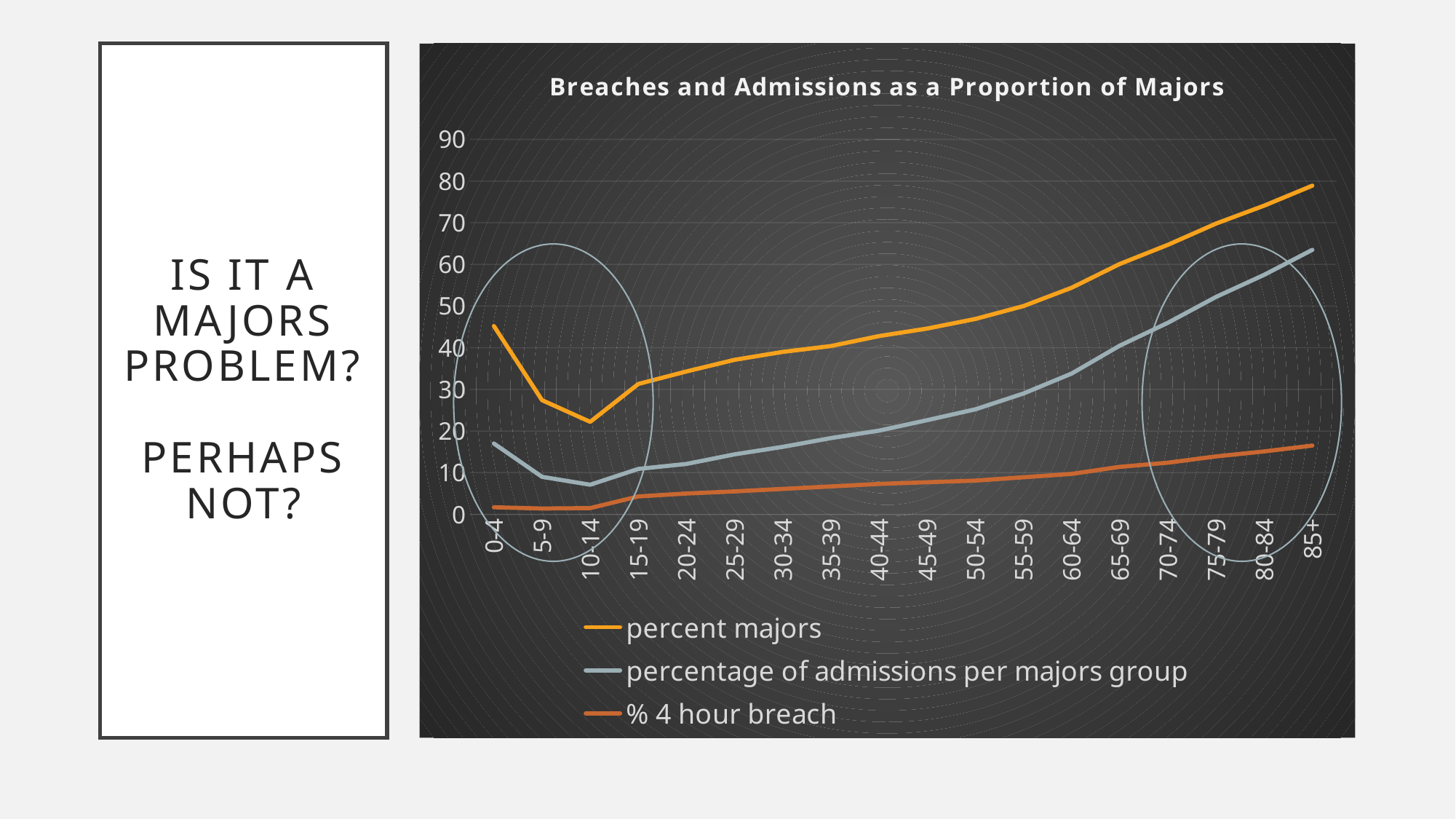
Does the '% 4 hour breach' series rise or fall from 15-19 to 85+? rise Is the 'percent majors' value for 10-14 greater or less than 30? less What kind of chart is shown on the slide? line chart For which age group is the 'percentage of admissions per majors group' series lowest? 10-14 For which age group is the 'percent majors' series lowest? 10-14 How many series does the legend list? 3 For which age group is the 'percent majors' series highest? 85+ How many age-group categories are plotted along the x axis? 18 Is the 'percent majors' value for 85+ greater or less than 70? greater At 85+, which is larger: 'percent majors' or 'percentage of admissions per majors group'? percent majors Is the '% 4 hour breach' value for 85+ greater or less than 20? less What is the title of the chart? Breaches and Admissions as a Proportion of Majors